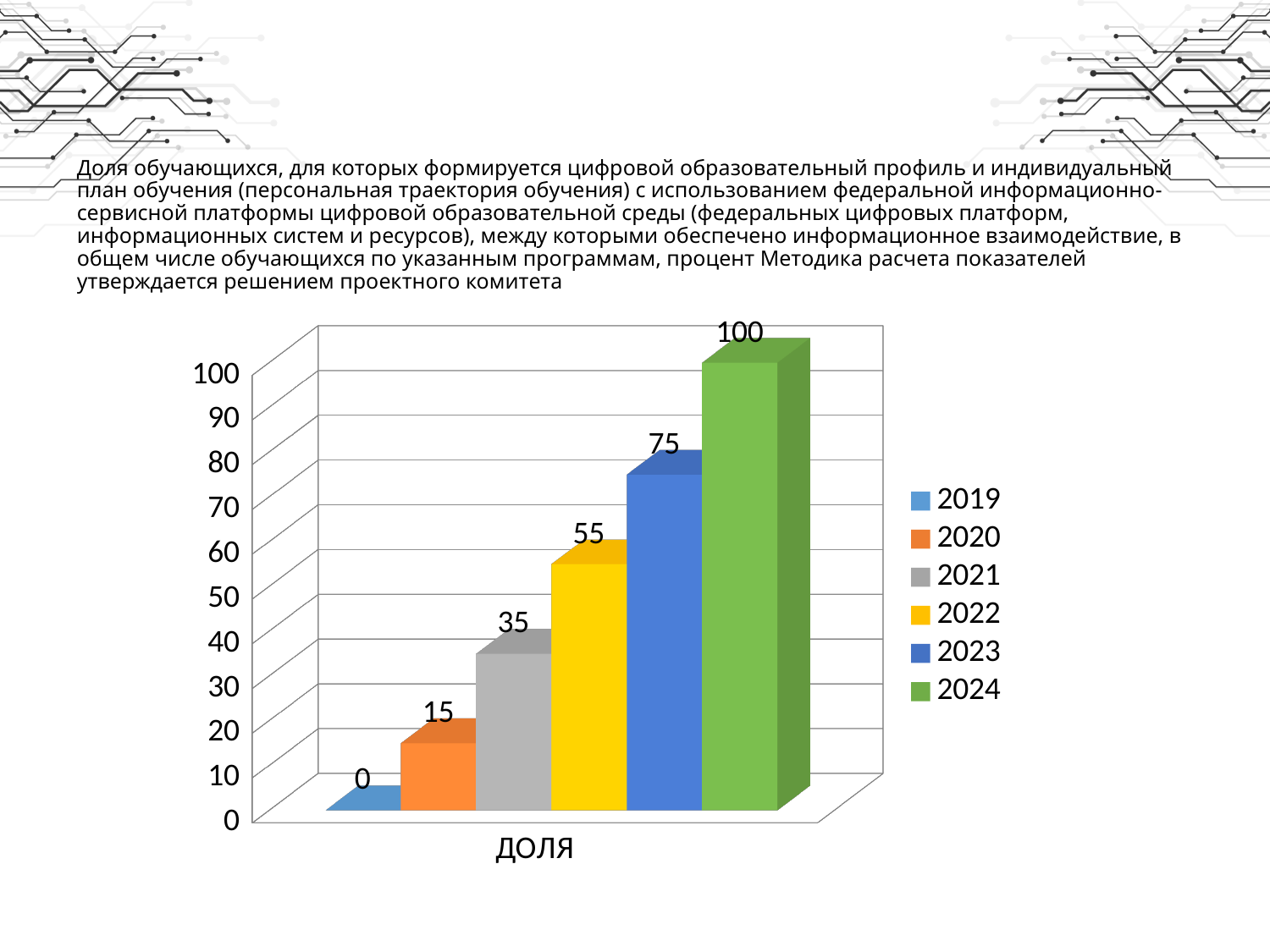
Which year has the lowest value? 2019 How many series does the legend list? 6 What is the difference between the values for 2024 and 2023? 25 What is the value for 2023? 75 What is the value for 2021? 35 Do the values rise or fall from 2019 to 2024? rise What kind of chart is shown on the slide? bar chart What is the category label shown on the x axis? ДОЛЯ What is the value for 2019? 0 What is the difference between the values for 2022 and 2020? 40 Which year has the highest value? 2024 Which is larger, the value for 2022 or the value for 2021? 2022